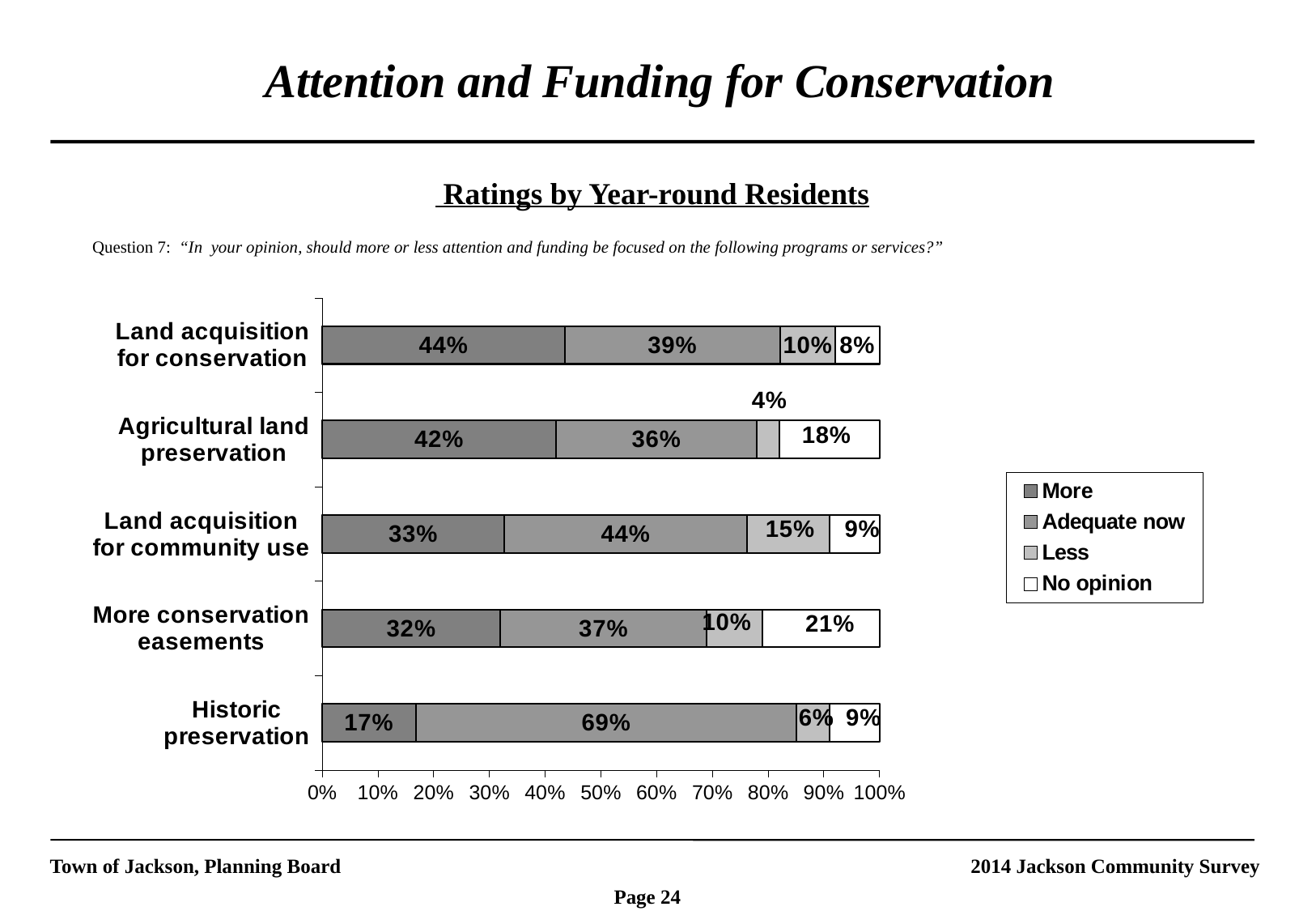
What is the total of the "More" and "Adequate now" segments for Land acquisition for community use? 77% Which category has the highest "More" value? Land acquisition for conservation Which is larger: the "No opinion" value for Agricultural land preservation or for More conservation easements? More conservation easements How many categories (programs or services) are shown on the chart? 5 What is the "Less" value for Agricultural land preservation? 4% Which category has the lowest "More" value? Historic preservation What percentage of year-round residents said "More" for Land acquisition for conservation? 44% What is the "Adequate now" value for Historic preservation? 69% What kind of chart is shown on the slide? Stacked bar chart What is the difference between the "Adequate now" values for Historic preservation and Land acquisition for community use? 25% How many series does the legend list? 4 What is the "No opinion" value for More conservation easements? 21%